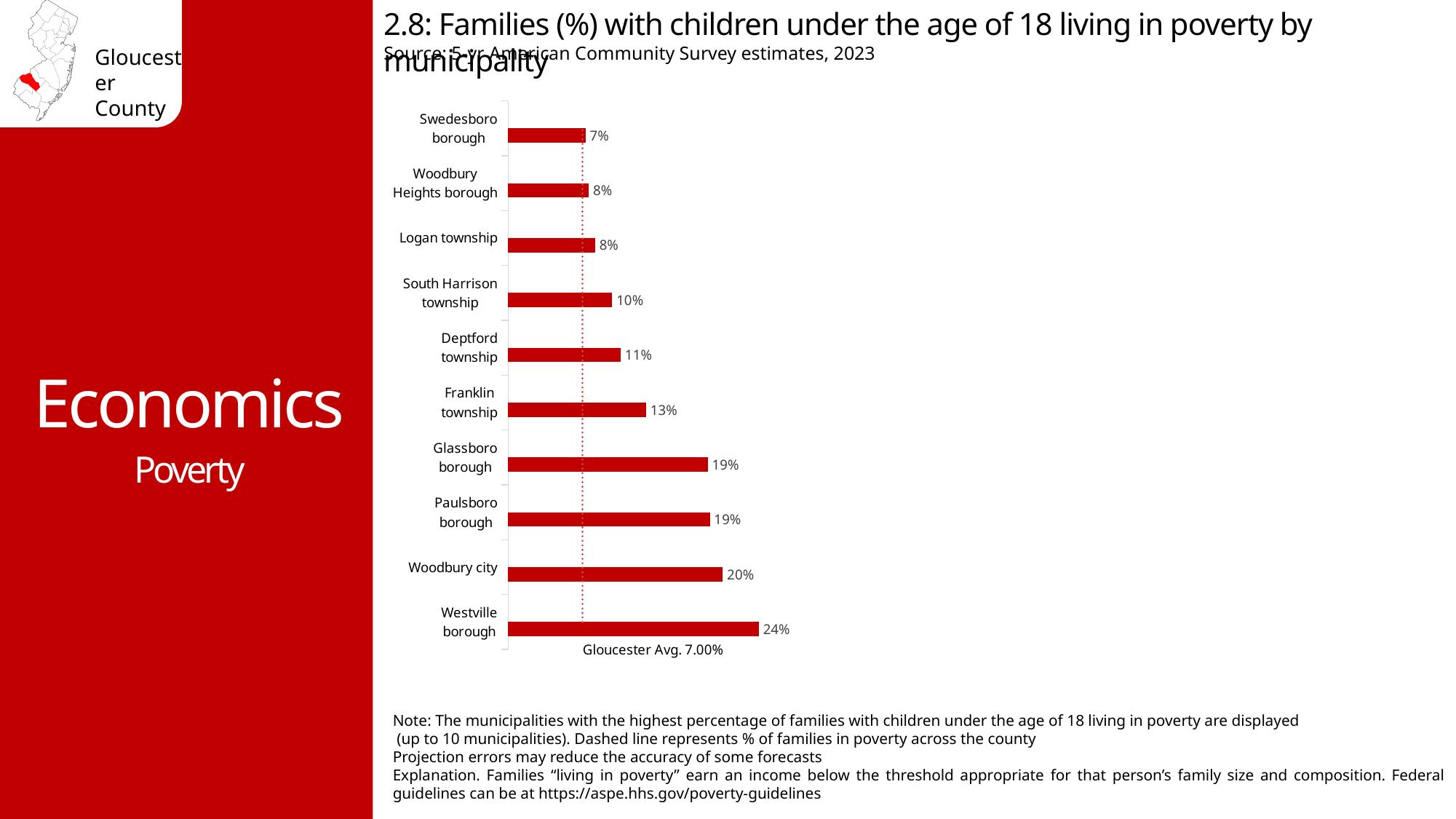
What percentage of families with children under 18 are living in poverty in Westville borough? 24% Which municipality has the highest percentage of families with children living in poverty? Westville borough Which municipality has the lowest percentage shown on the chart? Swedesboro borough How many municipalities are shown on the chart? 10 What is the value shown for Deptford township? 11% What is the Gloucester County average percentage indicated by the dashed line? 7.00% Which has a higher value, Woodbury city or South Harrison township? Woodbury city What is the value shown for Glassboro borough? 19% What is the value shown for Woodbury city? 20% What is the difference in percentage points between Paulsboro borough and Logan township? 11 What type of chart is used to display the data? Bar chart What is the difference in percentage points between Westville borough and Franklin township? 11